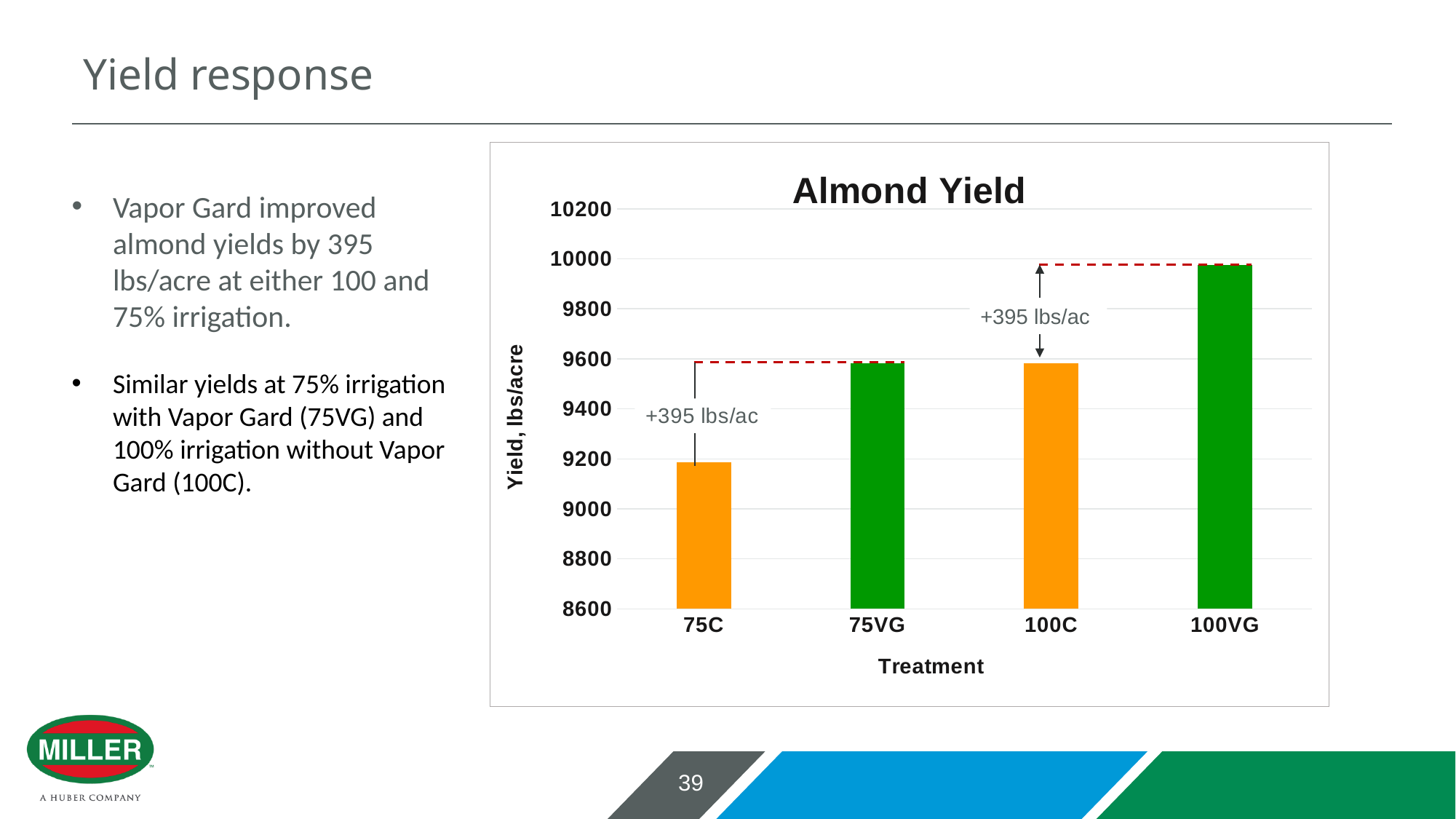
How many treatments are plotted on the x axis of the Almond Yield chart? 4 Which treatment has the lowest almond yield? 75C Is the yield for 100C greater or less than 9800? less What kind of chart is shown on the slide? bar chart What is the title of the chart? Almond Yield Is the yield for 75VG greater or less than 9400? greater According to the annotation on the chart, by how much does the yield of 75VG exceed that of 75C? +395 lbs/ac What is the label of the y axis? Yield, lbs/acre Which treatment has a higher yield, 100VG or 75C? 100VG Which treatment has the highest almond yield? 100VG Is the yield for 75C greater or less than 9400? less